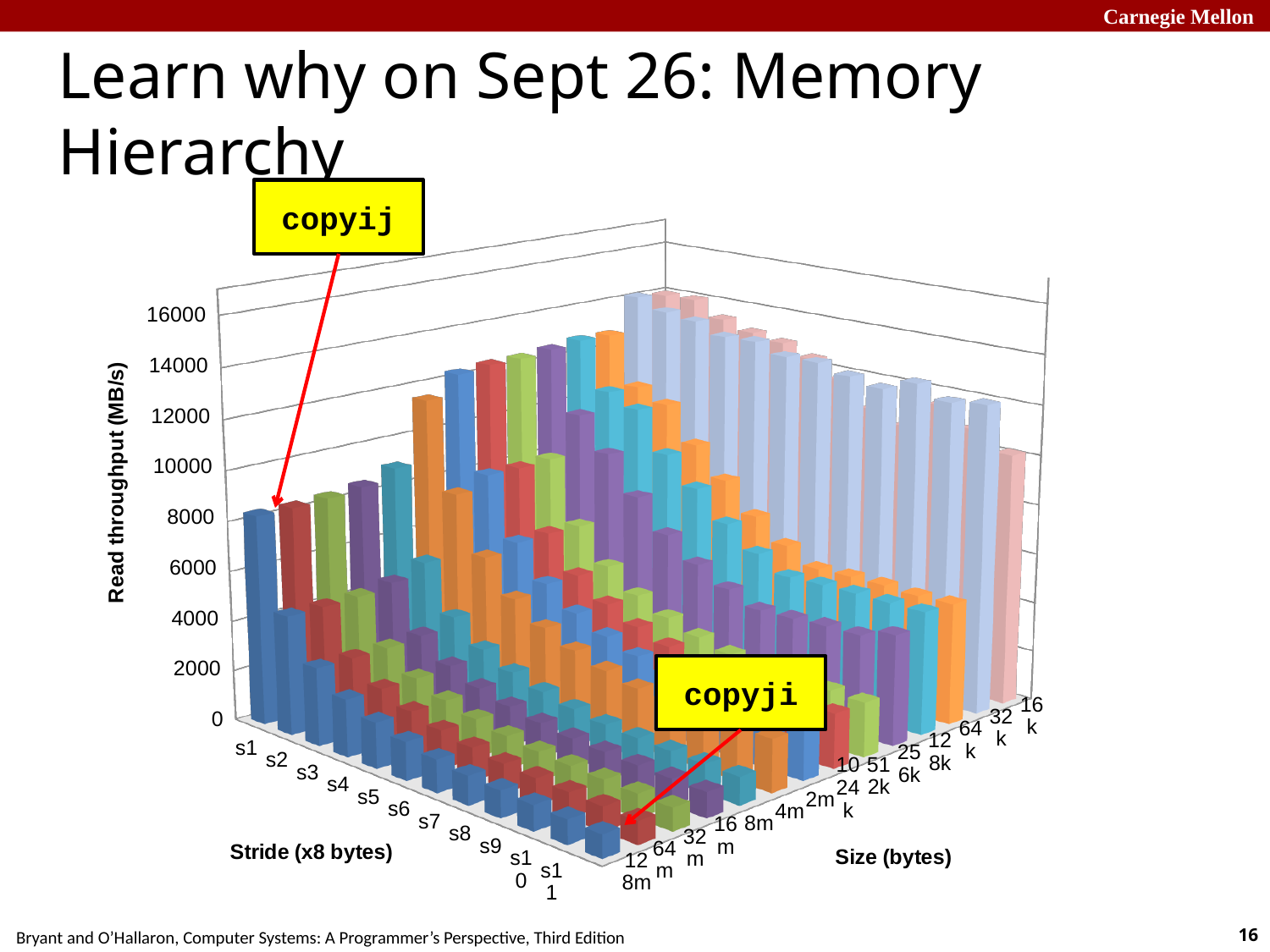
What is the title of the vertical axis of the chart? Read throughput (MB/s) Is the read throughput for stride s11 at size 128m greater or less than 4000? less Is the read throughput for stride s1 at size 128m greater or less than 4000? greater For size 128m, does read throughput rise or fall as the stride increases from s1 to s11? fall How many stride categories (s1, s2, ...) are shown on the stride axis? 11 For stride s1, does read throughput generally rise or fall as the size decreases from 128m to 16k? rise What is the highest tick value shown on the Read throughput axis? 16000 How many size categories are shown on the Size (bytes) axis? 14 Which stride has the higher read throughput at size 128m, s1 or s11? s1 What kind of chart is shown on the slide? 3D bar chart What is the label of the axis showing s1 through s11? Stride (x8 bytes)